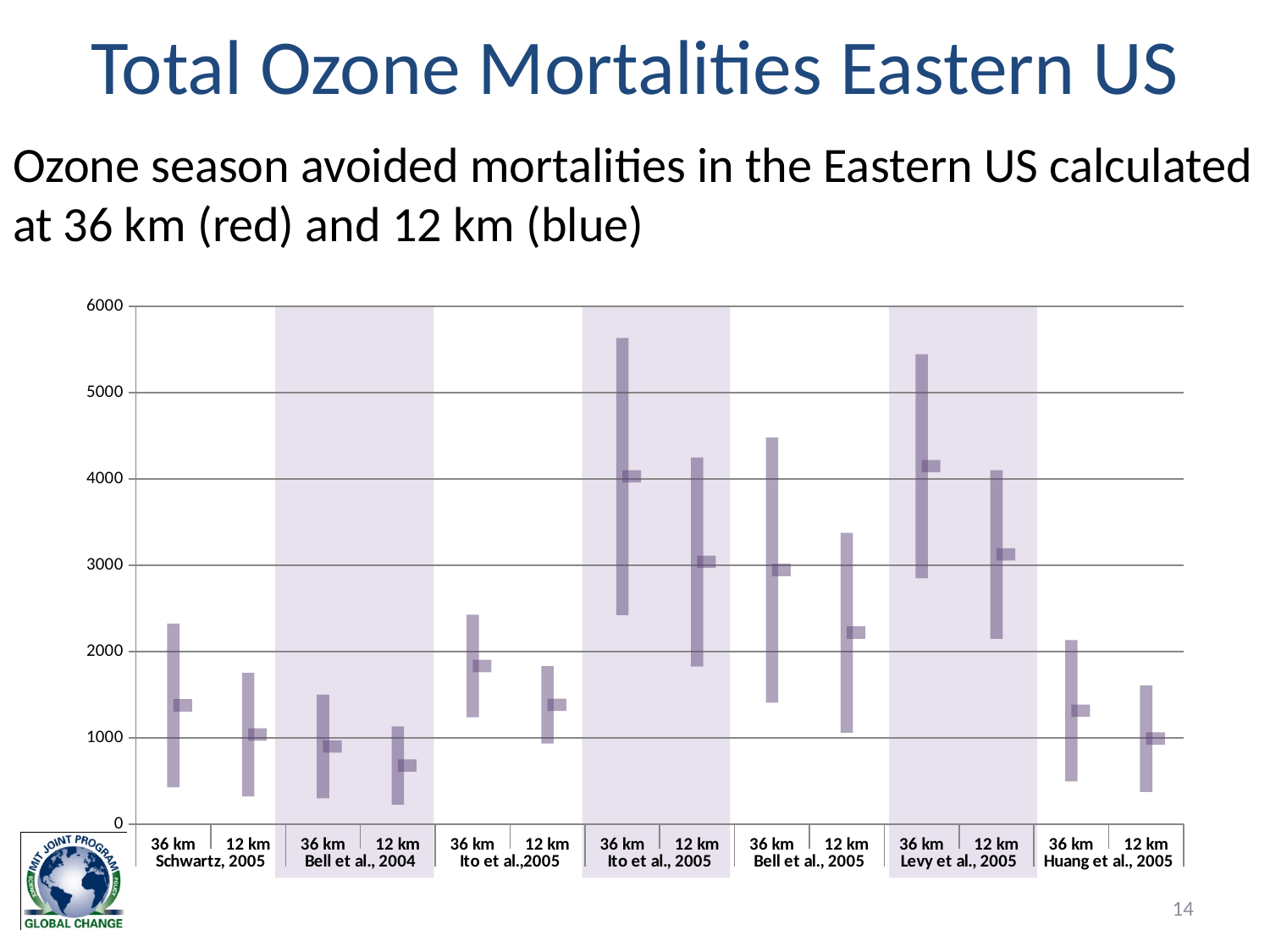
How many study groups are labelled along the x axis of the chart? 7 Is the central estimate for Bell et al., 2005 at 12 km greater or less than 2000? greater What kind of chart is shown on the slide? bar chart Which study group has the lowest central estimate at 12 km? Bell et al., 2004 How many bars (36 km and 12 km estimates combined) are plotted in the chart? 14 Is the central estimate for Bell et al., 2004 at 12 km greater or less than 1000? less Is the central estimate for Schwartz, 2005 at 36 km greater or less than 1000? greater Within each study group, is the 12 km central estimate higher or lower than the 36 km central estimate? lower What is the highest value shown on the y axis of the chart? 6000 Which has the larger central estimate: Bell et al., 2005 at 36 km or Bell et al., 2005 at 12 km? 36 km